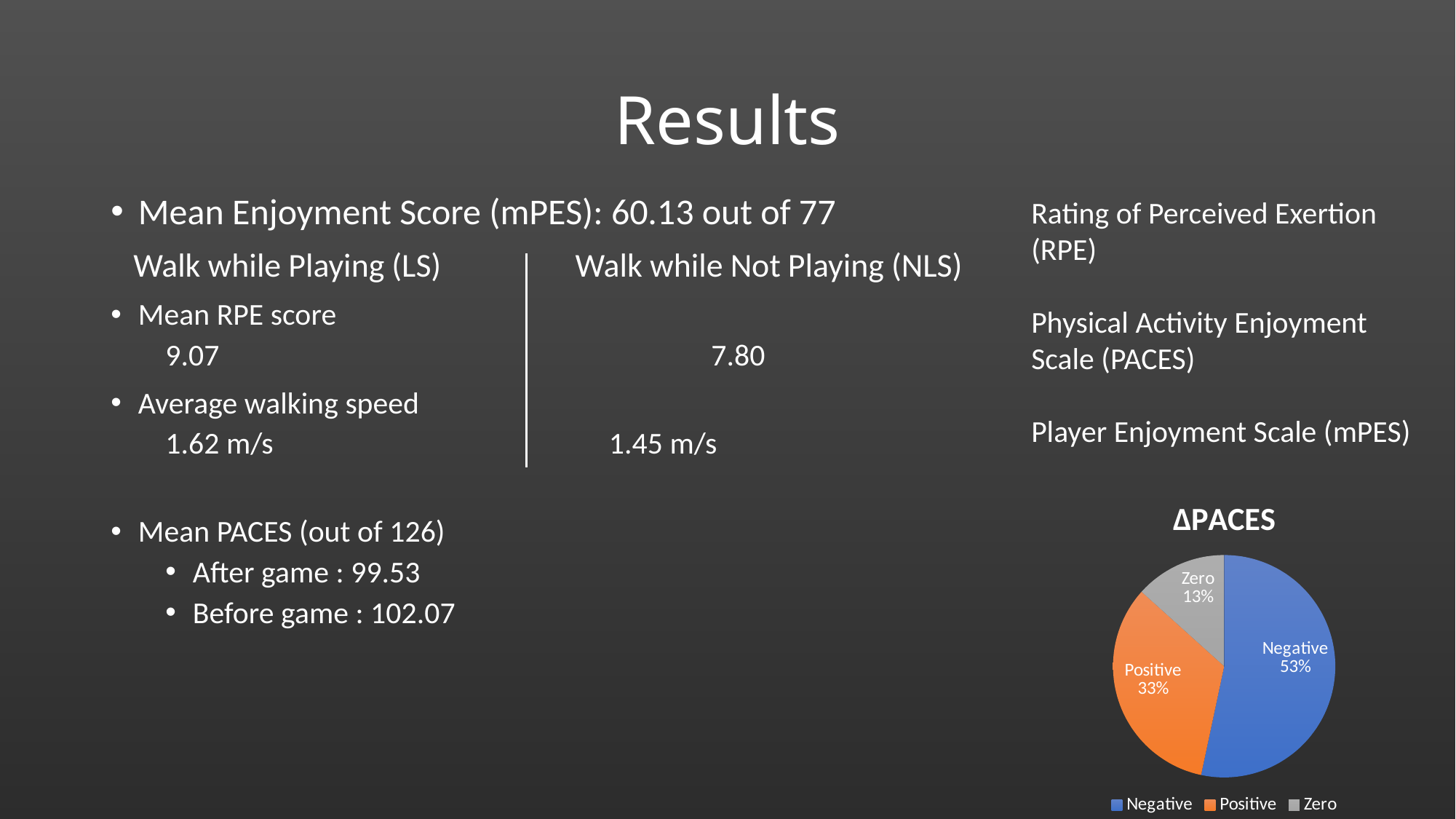
What is the title of the pie chart? ΔPACES Which slice of the ΔPACES pie is the largest? Negative How many slices does the ΔPACES pie chart have? 3 What kind of chart is the ΔPACES chart? pie chart What share of the ΔPACES pie is Zero? 13% What share of the ΔPACES pie is Positive? 33% In the ΔPACES pie chart, what is the difference in percentage points between the Negative and Positive slices? 20 How many entries does the legend of the ΔPACES pie chart list? 3 Which slice of the ΔPACES pie is the smallest? Zero In the ΔPACES pie chart, which is larger, the Positive slice or the Zero slice? Positive What share of the ΔPACES pie is Negative? 53% What colour is the Negative slice in the ΔPACES pie chart? blue